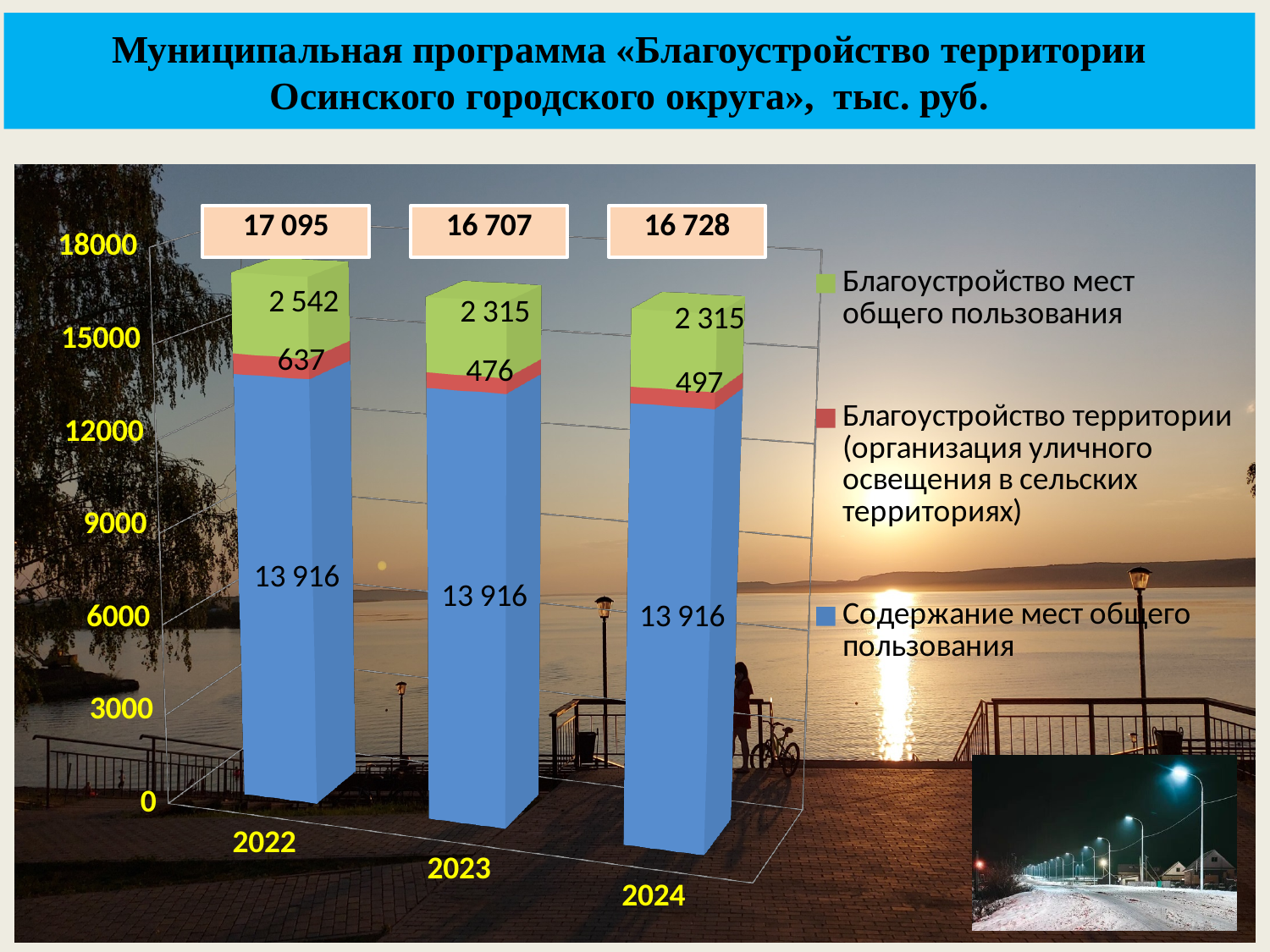
What is the total of the stacked bar for 2022? 17 095 What is the difference between the total for 2022 and the total for 2024? 367 What unit of measurement is stated in the chart title? тыс. руб. What type of chart is shown on the slide? stacked bar chart How many series does the chart legend list? 3 How many years (categories) are shown on the x axis of the chart? 3 Which year has the lowest total value? 2023 What is the value for «Содержание мест общего пользования» in 2024? 13 916 Is the value for «Благоустройство территории (организация уличного освещения в сельских территориях)» in 2024 larger or smaller than in 2023? larger What is the value for «Благоустройство мест общего пользования» in 2022? 2 542 What is the value for «Благоустройство территории (организация уличного освещения в сельских территориях)» in 2023? 476 Which year has the highest value for «Благоустройство территории (организация уличного освещения в сельских территориях)»? 2022